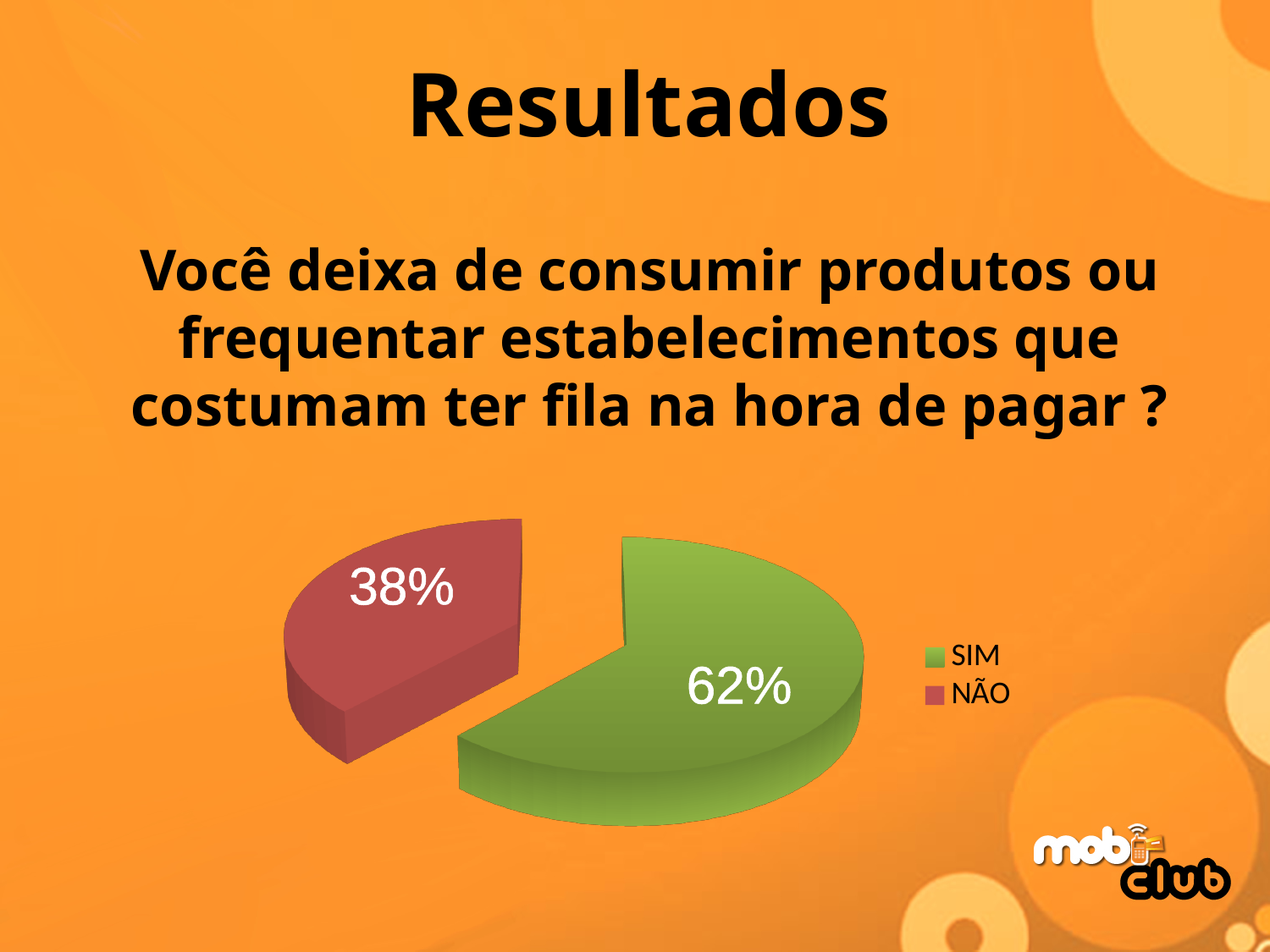
Which slice is the largest? SIM Which slice is the smallest? NÃO What share of the pie does SIM represent? 62% Which is larger, SIM or NÃO? SIM What share of the pie does NÃO represent? 38% What kind of chart is shown on the slide? pie chart What colour is the SIM slice? green How many entries does the legend list? 2 What colour is the NÃO slice? red What is the difference in percentage points between SIM and NÃO? 24 How many slices does the pie chart have? 2